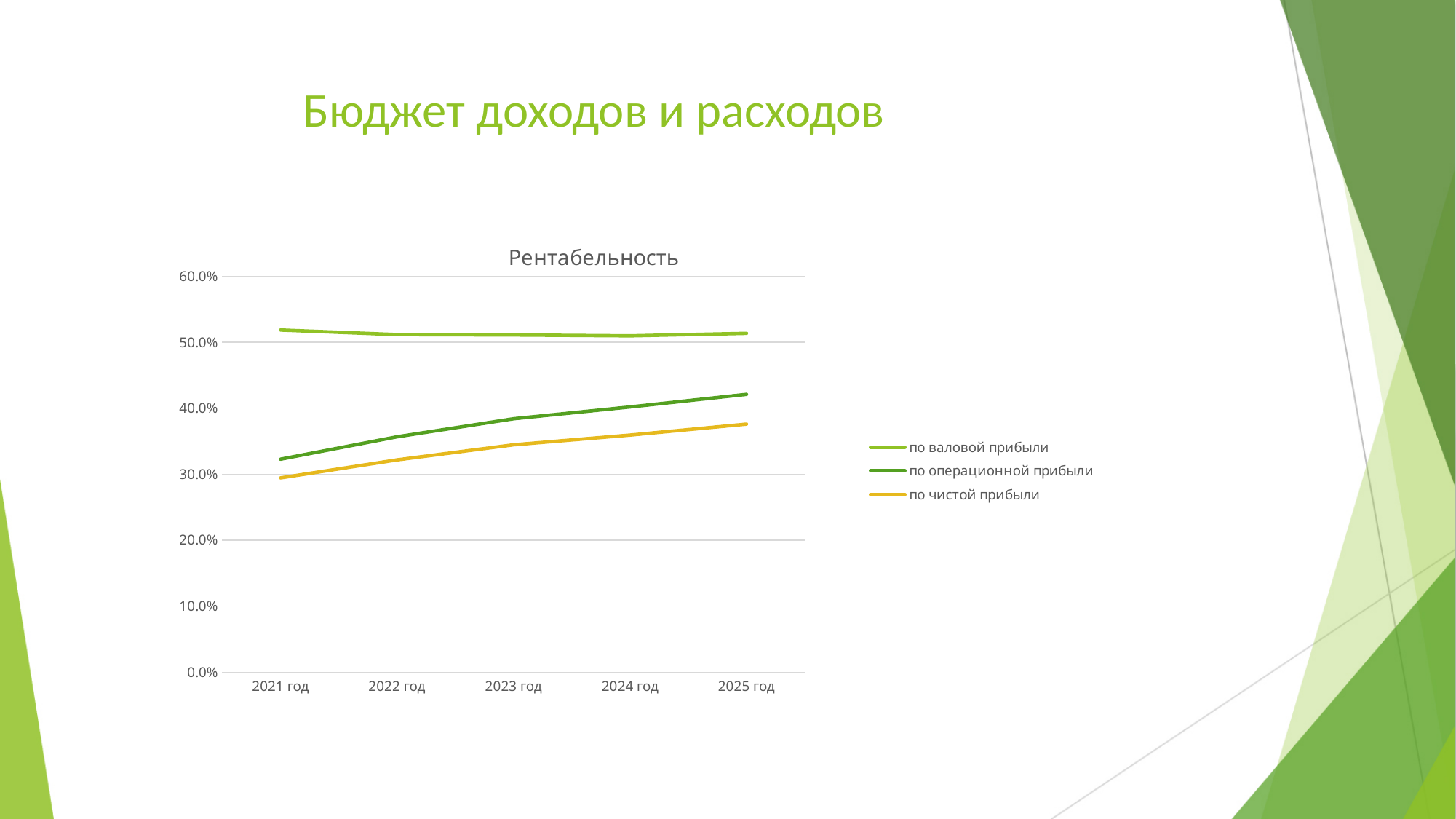
Does the value for по операционной прибыли rise or fall from 2021 год to 2025 год? rise Which series has the lowest value in 2025 год? по чистой прибыли How many series does the legend list? 3 What kind of chart is shown on the slide? line chart How many years are shown on the x axis? 5 In which year is the value for по операционной прибыли highest? 2025 год In which year is the value for по чистой прибыли lowest? 2021 год Is the value for по чистой прибыли in 2025 год greater or less than 40.0%? less Which series is plotted in yellow? по чистой прибыли What is the title of the chart? Рентабельность Is the value for по валовой прибыли in 2021 год greater or less than 50.0%? greater Which series has the highest value in 2021 год? по валовой прибыли